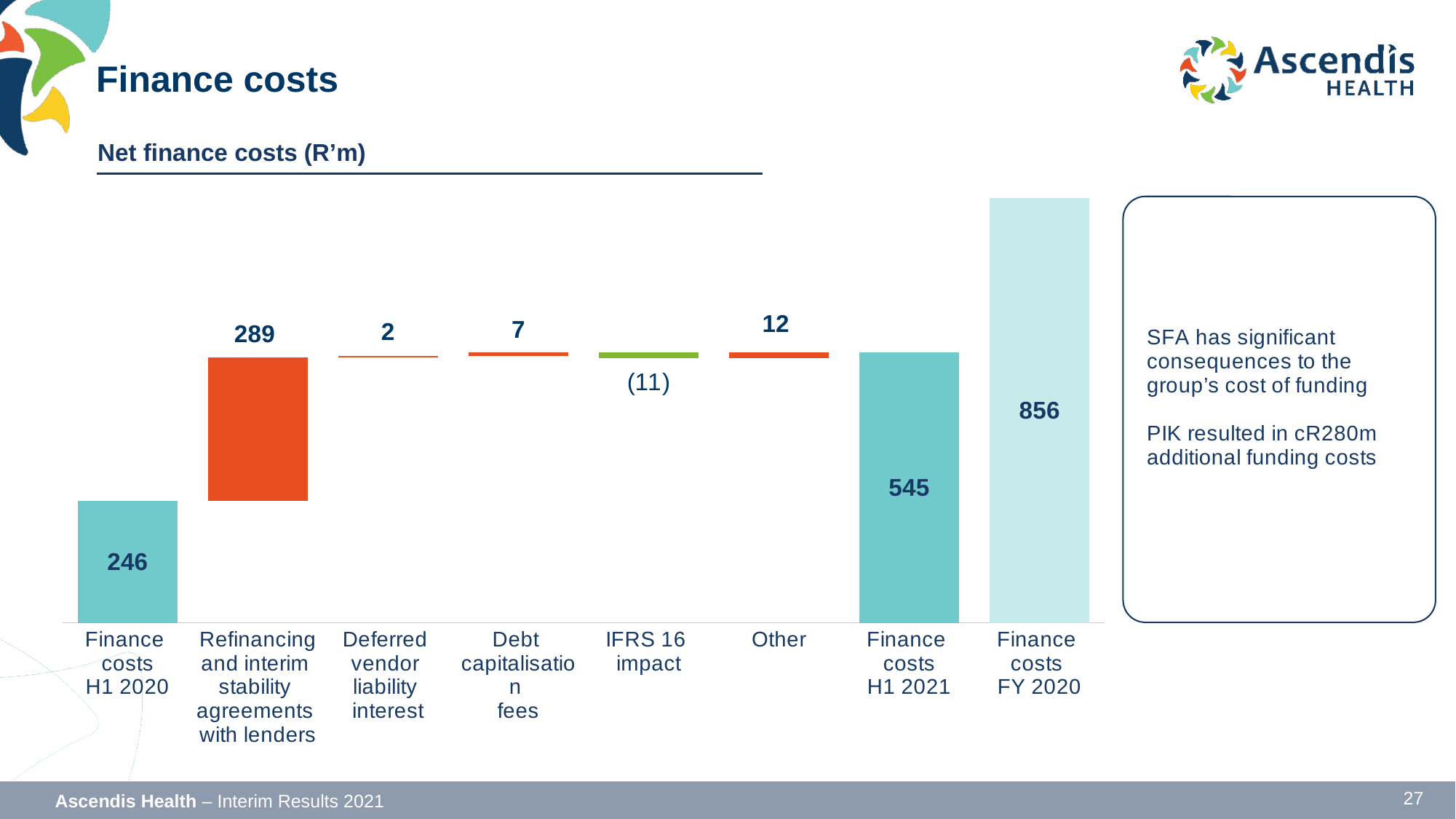
What is the value shown for IFRS 16 impact? (11) Which is larger, the value for Debt capitalisation fees or the value for Deferred vendor liability interest? Debt capitalisation fees What is the value for Finance costs H1 2021? 545 What is the value for Finance costs FY 2020? 856 Which category has the highest value? Finance costs FY 2020 What is the value for Refinancing and interim stability agreements with lenders? 289 What is the title of the chart? Net finance costs (R'm) How many categories are shown on the x axis? 8 What kind of chart is shown? Waterfall bar chart What is the value for Other? 12 What is the difference between Finance costs H1 2021 and Finance costs H1 2020? 299 What is the value for Finance costs H1 2020? 246